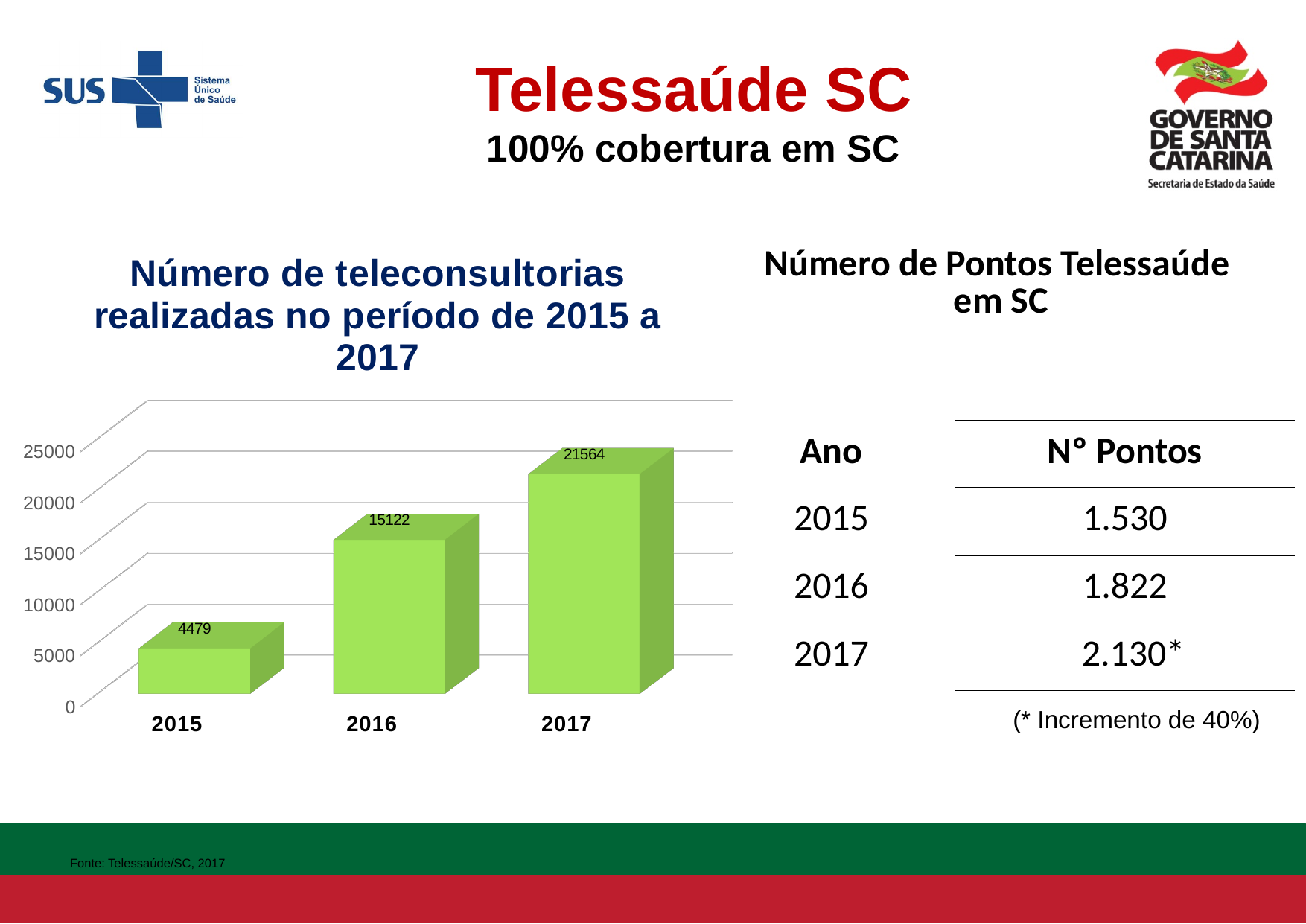
How many years are plotted in the chart? 3 What is the number of teleconsultorias shown for 2015? 4479 Which year has the highest number of teleconsultorias? 2017 Which is larger, the value for 2016 or the value for 2015? 2016 What is the difference between the 2016 and 2015 values? 10643 What kind of chart is shown on the slide? bar chart What is the number of teleconsultorias shown for 2017? 21564 Which year has the lowest number of teleconsultorias? 2015 What is the difference between the 2017 and 2016 values? 6442 Is the value for 2017 greater or less than 20000? greater What is the number of teleconsultorias shown for 2016? 15122 Do the values rise or fall from 2015 to 2017? rise